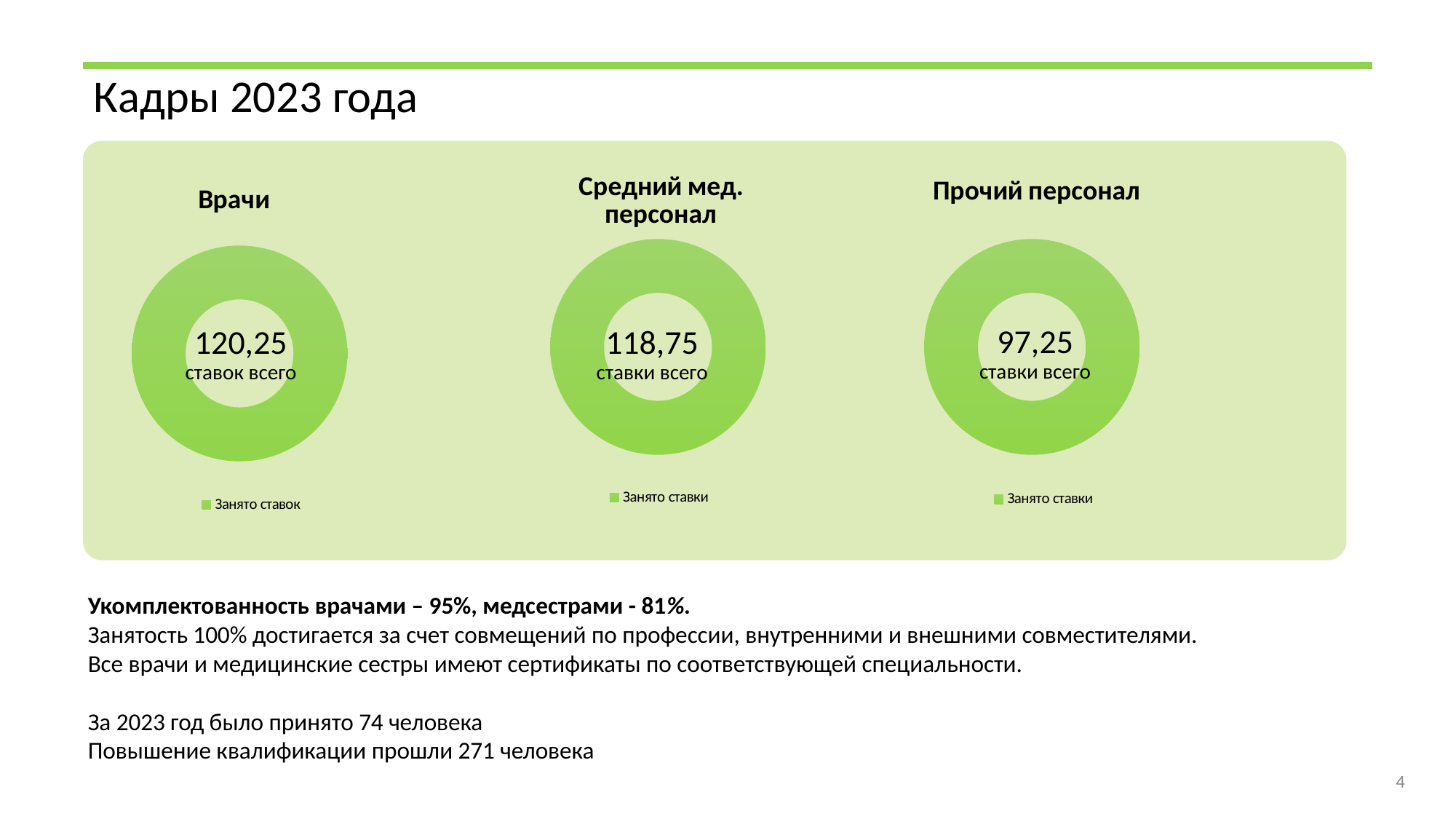
What is the difference between the total positions in the "Средний мед. персонал" chart and the "Прочий персонал" chart? 21,5 In the "Прочий персонал" chart, what total number of positions (ставки всего) is shown in the centre? 97,25 Which of the three charts shows the smallest total number of positions? Прочий персонал Which of the three charts shows the largest total number of positions? Врачи How many donut charts are shown on the slide? 3 What is the legend entry of the "Прочий персонал" chart? Занято ставки What kind of chart is used for the "Врачи" chart? Donut (pie) chart In the "Средний мед. персонал" chart, what total number of positions (ставки всего) is shown in the centre? 118,75 Which is larger: the total positions in the "Врачи" chart or in the "Прочий персонал" chart? Врачи In the "Врачи" chart, what total number of positions (ставок всего) is shown in the centre? 120,25 What is the difference between the total positions in the "Врачи" chart and the "Средний мед. персонал" chart? 1,5 How many series does the legend of the "Врачи" chart list? 1